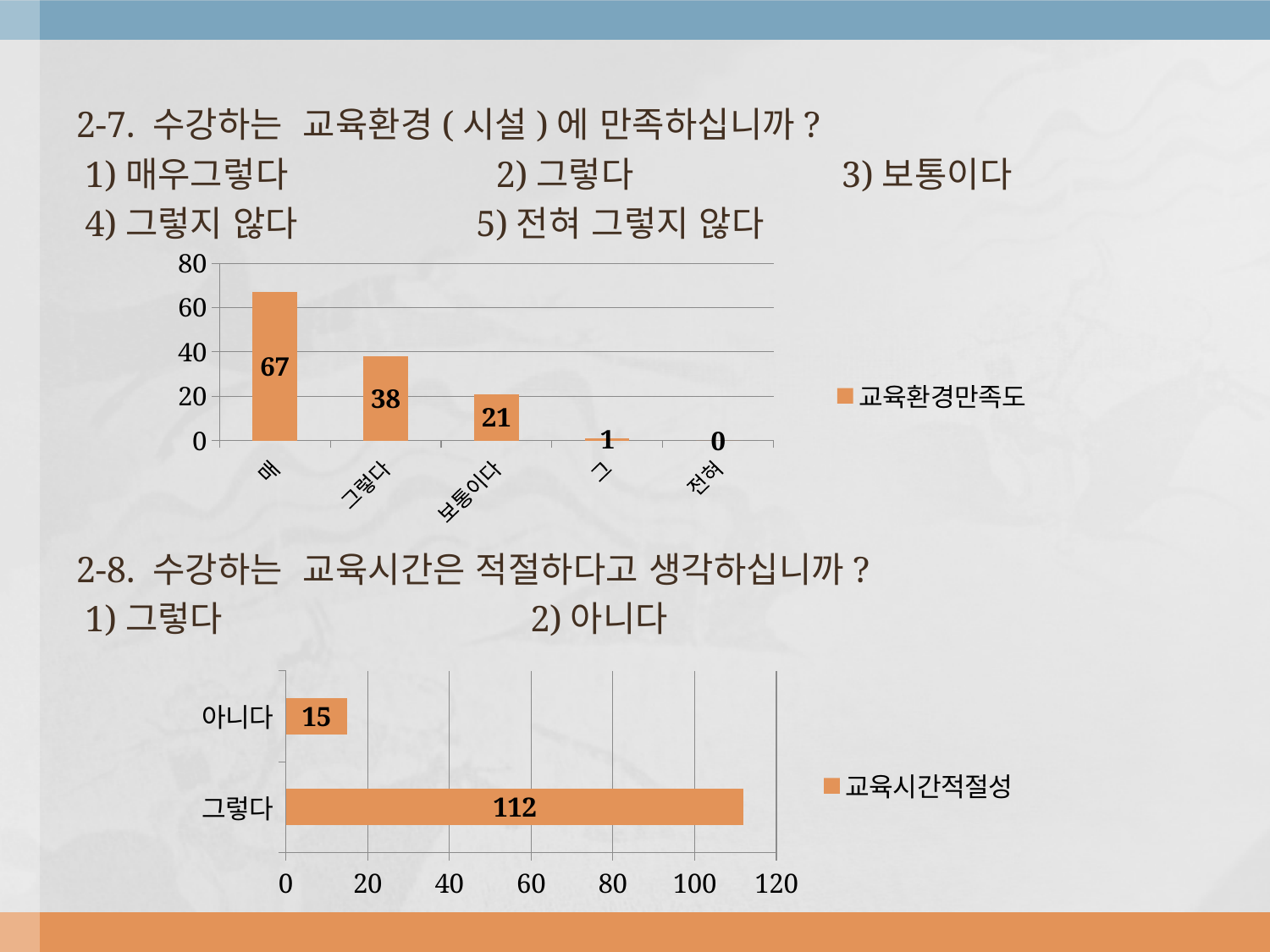
In the top chart (2-7), what is the value for 그렇다? 38 In the top chart (2-7), what is the value of the last (rightmost) bar? 0 In the top chart (2-7), what is the value for 보통이다? 21 In the top chart (2-7), what series name does the legend show? 교육환경만족도 In the bottom chart (2-8), what is the value for 그렇다? 112 In the bottom chart (2-8), what is the difference between the values for 그렇다 and 아니다? 97 What type of chart is the bottom chart (2-8)? bar chart In the bottom chart (2-8), what is the value for 아니다? 15 In the top chart (2-7), what is the value of the first (leftmost) bar? 67 In the top chart (2-7), do the values rise or fall from left to right? fall In the top chart (2-7), how many bars (categories) are shown? 5 In the top chart (2-7), what is the difference between the values for 그렇다 and 보통이다? 17